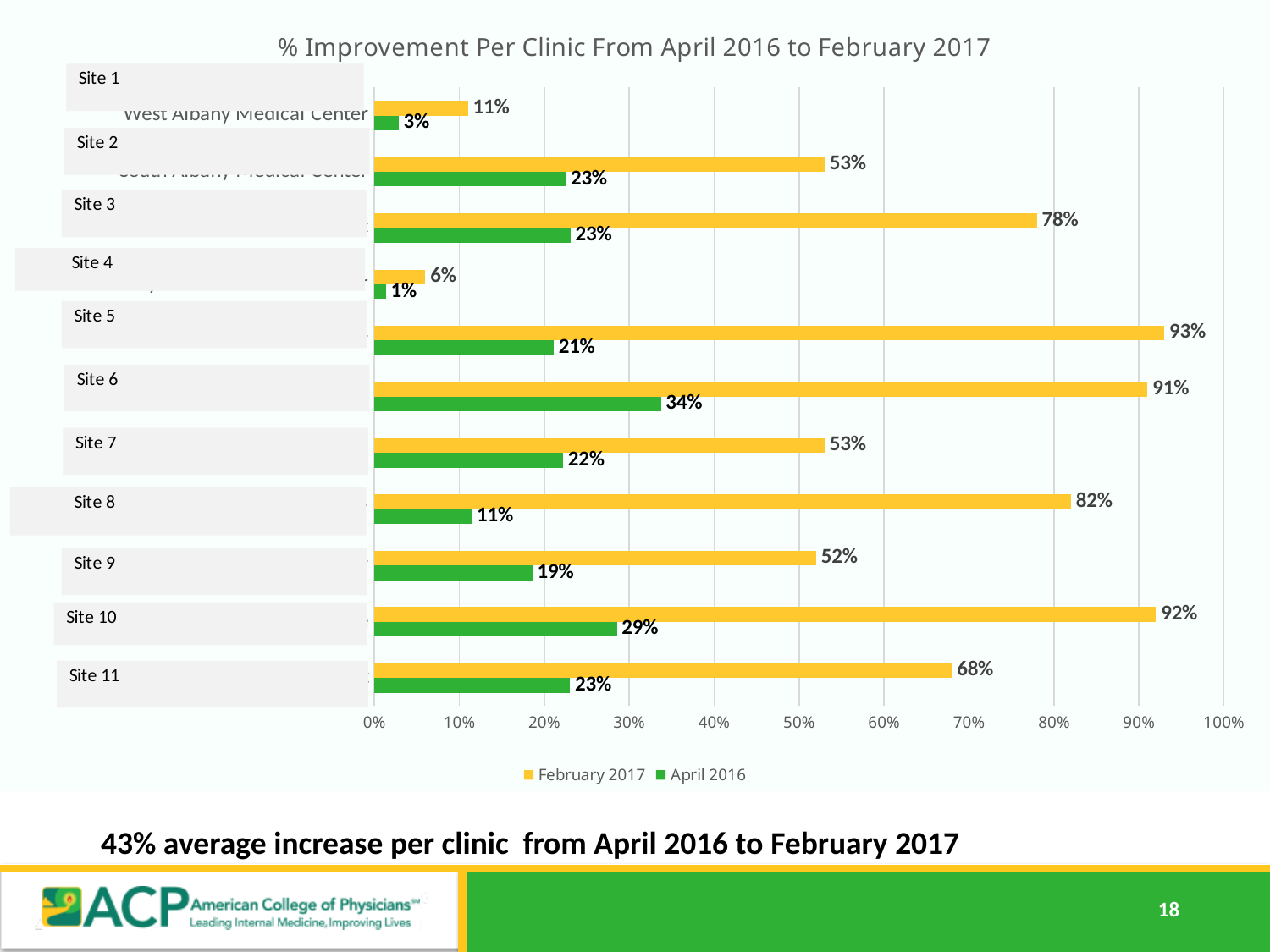
Which site has the highest April 2016 value? Site 6 What is the April 2016 value for Site 6? 34% How many sites are shown on the chart? 11 Which colour represents April 2016 in the chart? Green How many series does the legend list? 2 Which site has the lowest February 2017 value? Site 4 What is the February 2017 value for Site 8? 82% What kind of chart is shown on the slide? Bar chart Which is larger, the February 2017 value for Site 3 or the February 2017 value for Site 11? Site 3 What is the February 2017 value for Site 5? 93% What is the difference between the February 2017 and April 2016 values for Site 10? 63% Is the February 2017 value for Site 2 greater or less than 50%? greater